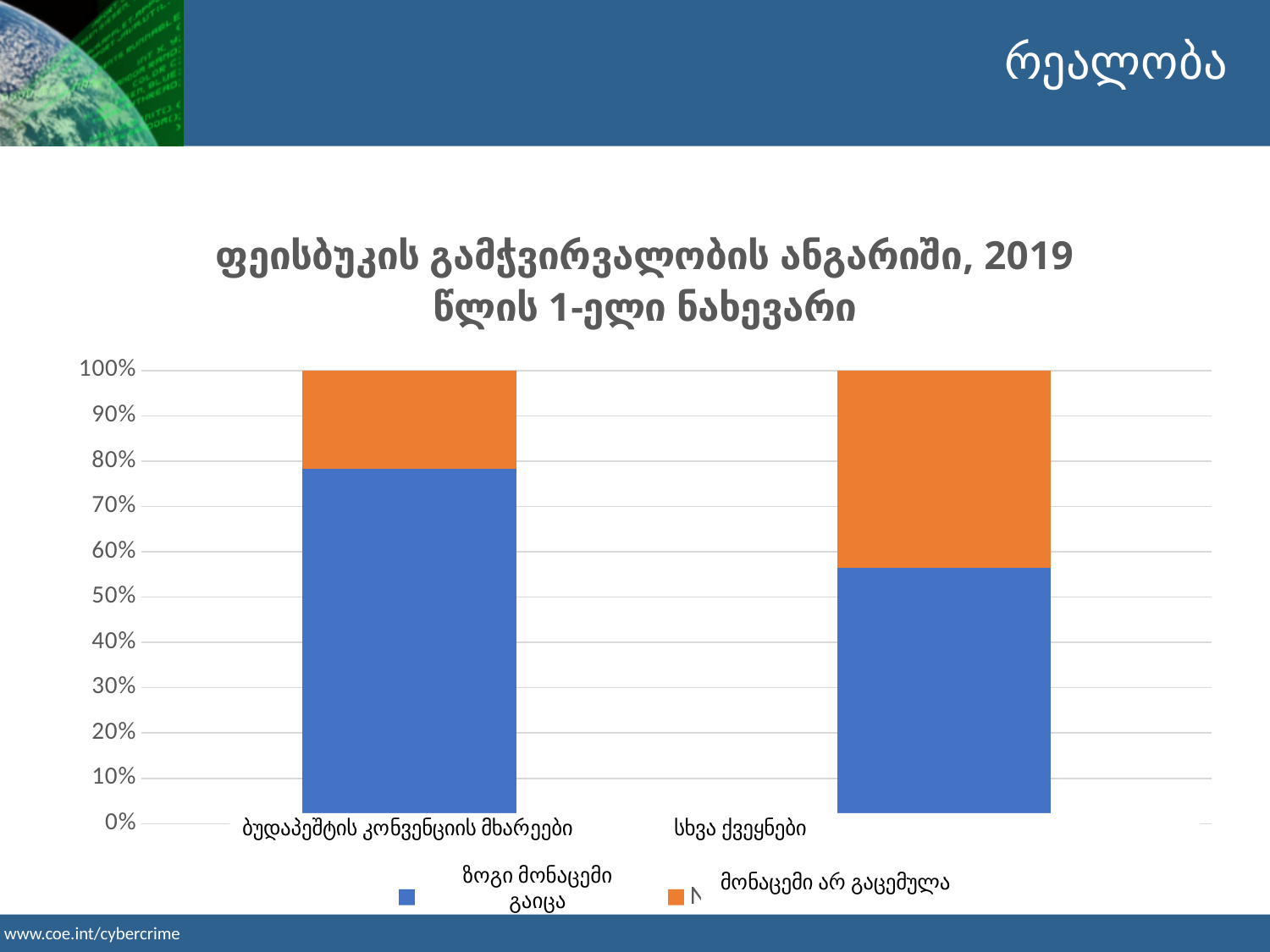
Which category has the larger share of 'მონაცემი არ გაცემულა'? სხვა ქვეყნები Is the value of 'ზოგი მონაცემი გაიცა' for 'სხვა ქვეყნები' greater or less than 60%? less Is the value of 'მონაცემი არ გაცემულა' for 'სხვა ქვეყნები' greater or less than 40%? greater Which series is shown in blue in the chart? ზოგი მონაცემი გაიცა Is the value of 'ზოგი მონაცემი გაიცა' for 'ბუდაპეშტის კონვენციის მხარეები' greater or less than 70%? greater What is the total height of the stacked bar for 'სხვა ქვეყნები'? 100% How many series does the legend list? 2 What is the title of the chart? ფეისბუკის გამჭვირვალობის ანგარიში, 2019 წლის 1-ელი ნახევარი Which category has the larger share of 'ზოგი მონაცემი გაიცა': 'ბუდაპეშტის კონვენციის მხარეები' or 'სხვა ქვეყნები'? ბუდაპეშტის კონვენციის მხარეები What kind of chart is shown on the slide? stacked bar chart How many categories are shown on the x axis of the chart? 2